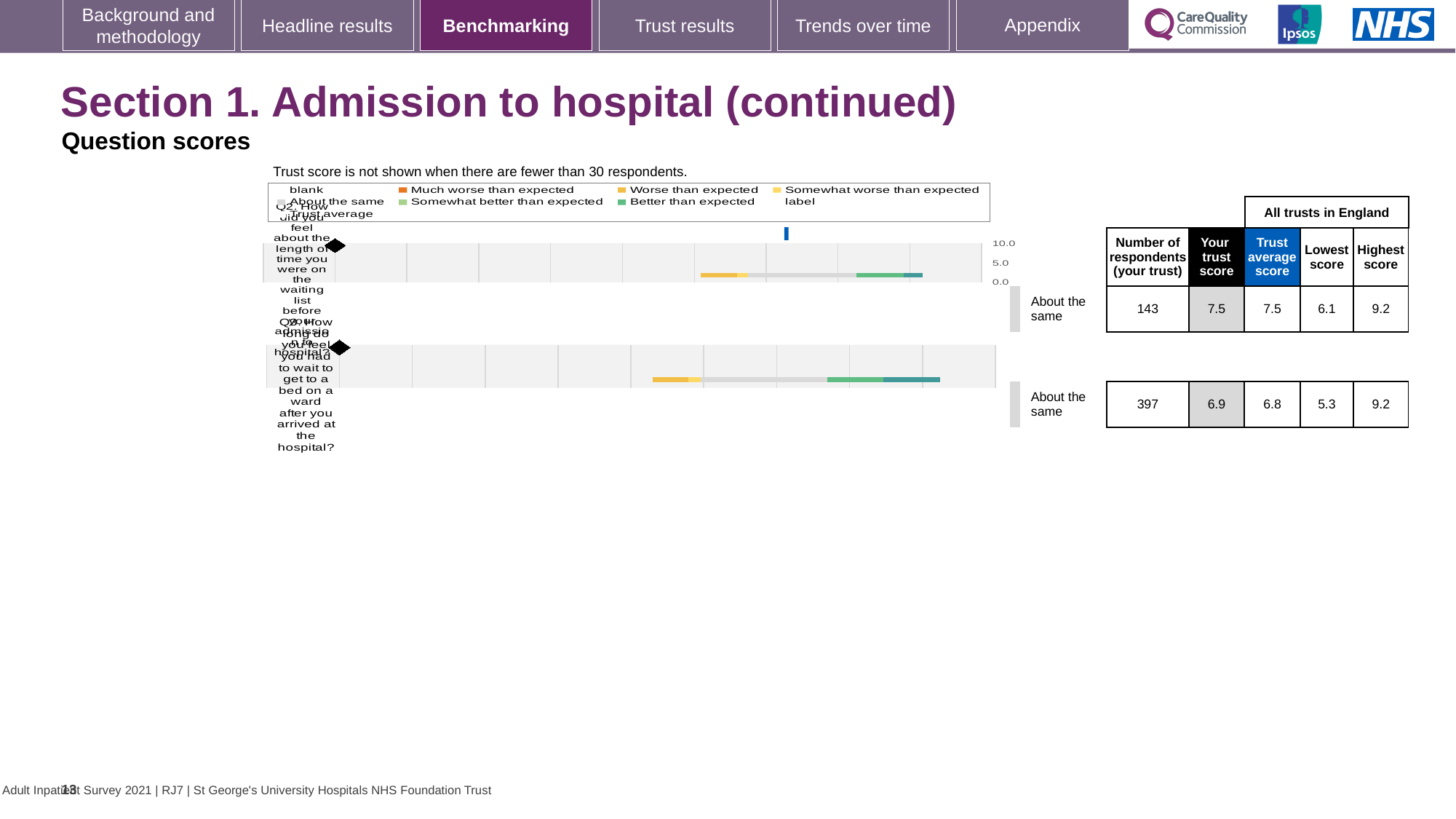
What is the highest score across all trusts in England for Q2? 9.2 What is the 'Your trust score' for Q2 (how did you feel about the length of time you were on the waiting list before admission)? 7.5 What benchmark category label is shown next to the Q2 chart? About the same What is the lowest score across all trusts in England for Q3? 5.3 For Q2, what is the difference between the highest score and the lowest score across all trusts in England? 3.1 For Q3, how much higher is your trust score than the trust average score? 0.1 What kind of chart is used to show the question scores? Bar chart How many respondents from your trust answered Q3? 397 What is the 'Your trust score' for Q3 (how long did you feel you had to wait to get to a bed on a ward)? 6.9 How many respondents from your trust answered Q2? 143 What is the trust average score for Q3? 6.8 Which question had more respondents from your trust, Q2 or Q3? Q3